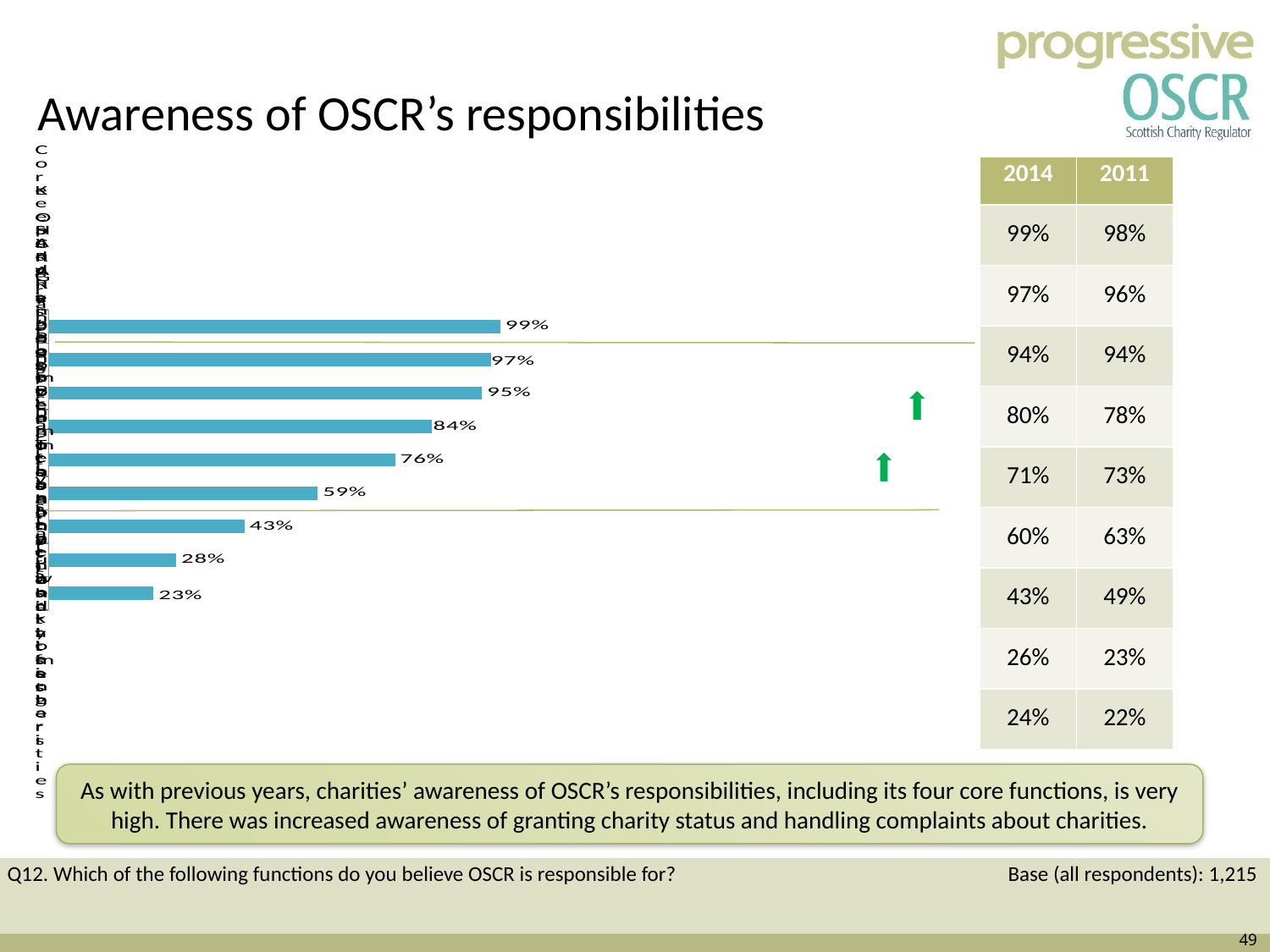
What is the value of the sixth bar from the top in the chart? 59% What is the value of the topmost bar in the chart? 99% What is the value of the bottom bar in the chart? 23% What type of chart is shown on the slide? Bar chart How many bars are plotted in the chart? 9 What is the value of the fourth bar from the top in the chart? 84% What is the lowest value shown in the chart? 23% Which is larger: the fifth bar from the top or the sixth bar from the top? The fifth bar (76%) Do the bar values increase or decrease going from the top of the chart to the bottom? Decrease What is the difference between the highest and lowest values in the chart? 76 percentage points What is the title of the slide containing the chart? Awareness of OSCR's responsibilities What is the highest value shown in the chart? 99%